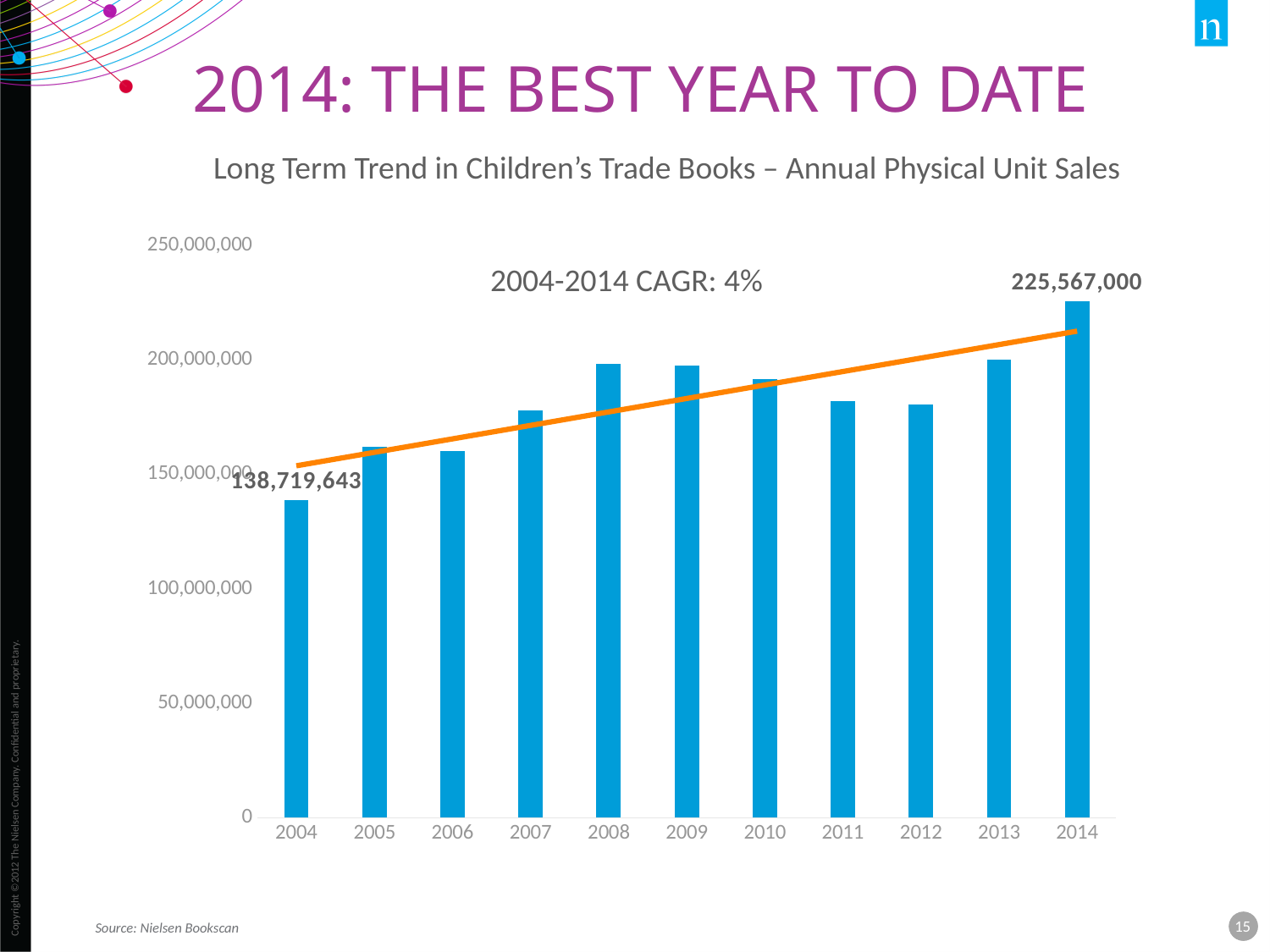
Which year has the larger value, 2008 or 2012? 2008 What kind of chart is shown on the slide? Bar chart How many years are shown on the x axis? 11 Do the values generally rise or fall from 2004 to 2014? Rise What is the value for 2004? 138,719,643 Which year has the lowest annual physical unit sales? 2004 Which year has the highest annual physical unit sales? 2014 Is the value for 2008 greater or less than 150,000,000? greater What is the 2004-2014 CAGR stated on the chart? 4% What is the difference between the 2014 value and the 2004 value? 86,847,357 Is the value for 2006 greater or less than 200,000,000? less What is the value for 2014? 225,567,000